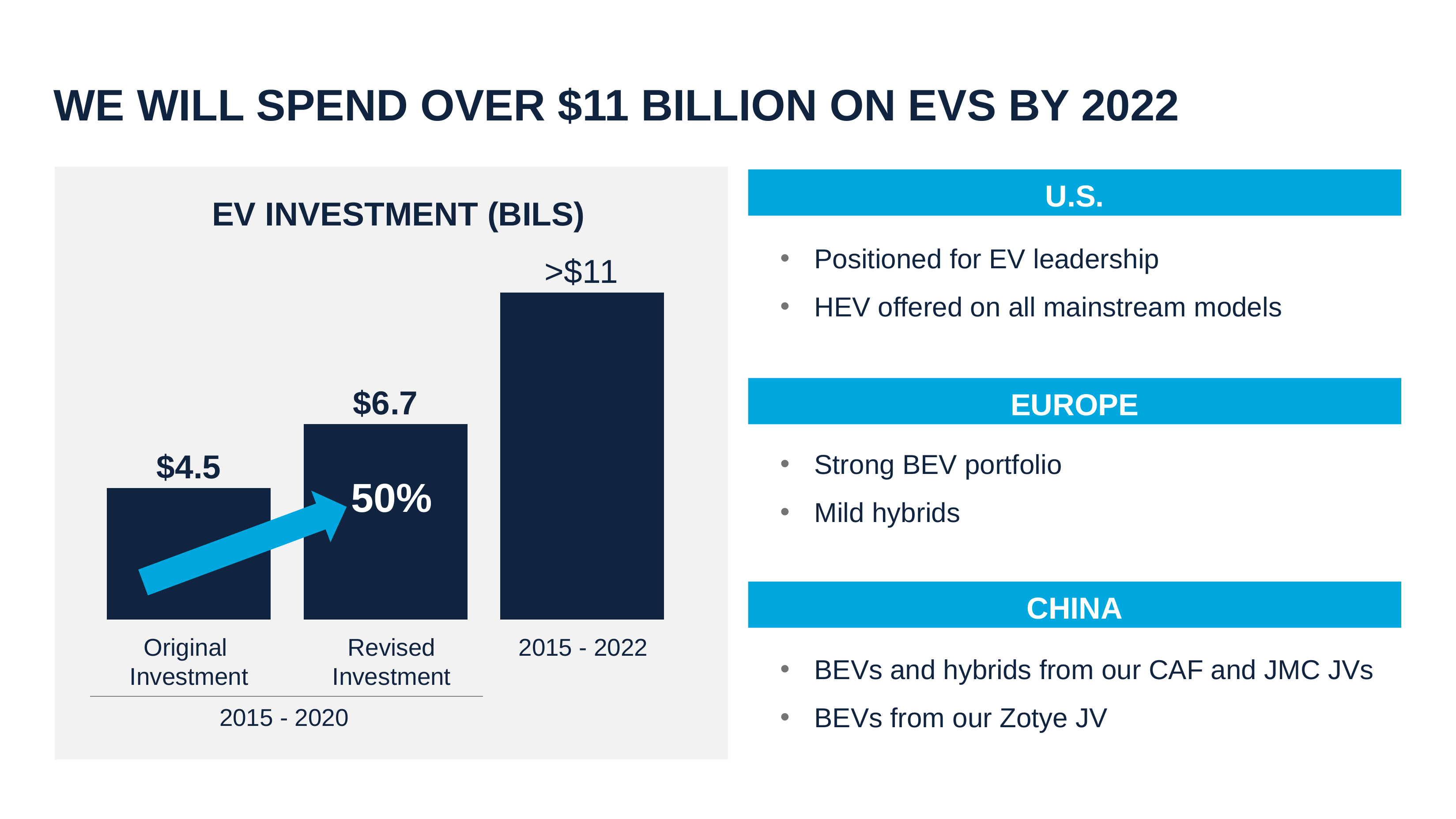
What is the value of the Original Investment bar? $4.5 What value is labelled on the 2015 - 2022 bar? >$11 Do the bar values rise or fall from left to right? Rise Which is larger, the Original Investment or the Revised Investment? Revised Investment How many bars are shown in the chart? 3 Which bar has the highest value? 2015 - 2022 Which bar has the lowest value? Original Investment What is the difference between the Revised Investment and the Original Investment? $2.2 What type of chart is shown on the slide? Bar chart What is the value of the Revised Investment bar? $6.7 What is the title of the chart? EV INVESTMENT (BILS) What percentage is shown next to the arrow between the Original and Revised Investment bars? 50%